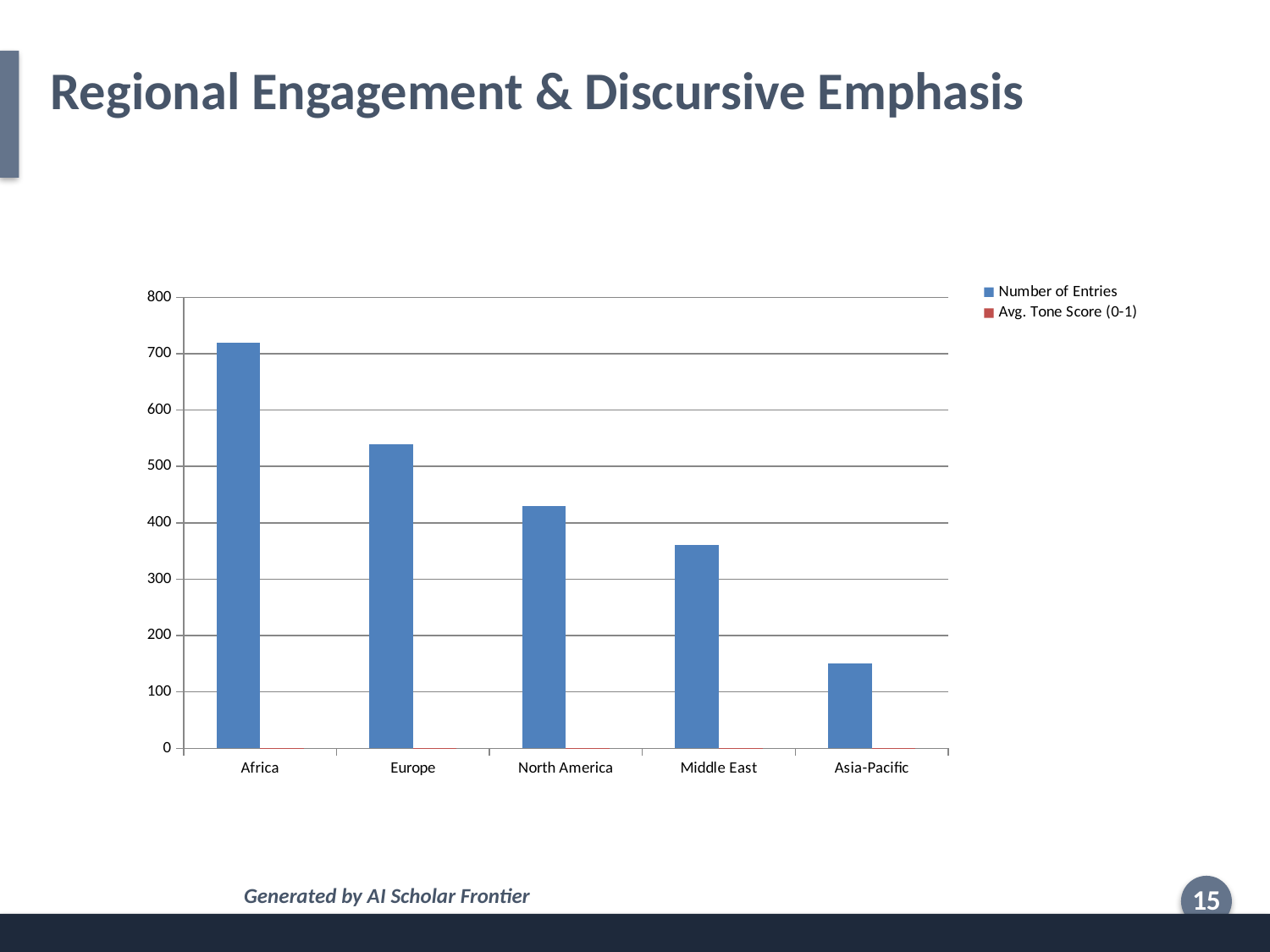
Is the Number of Entries for Asia-Pacific greater or less than 200? less How many series does the chart's legend list? 2 Do the Number of Entries values rise or fall moving from Africa to Asia-Pacific along the x axis? fall How many regions are shown on the x axis of the chart? 5 Which region has the lowest Number of Entries? Asia-Pacific Which has a larger Number of Entries, Europe or Middle East? Europe Is the Number of Entries for Europe greater or less than 500? greater What is the second series listed in the chart's legend? Avg. Tone Score (0-1) Is the Number of Entries for North America greater or less than 500? less What kind of chart is shown on the slide? bar chart Which region has the highest Number of Entries? Africa